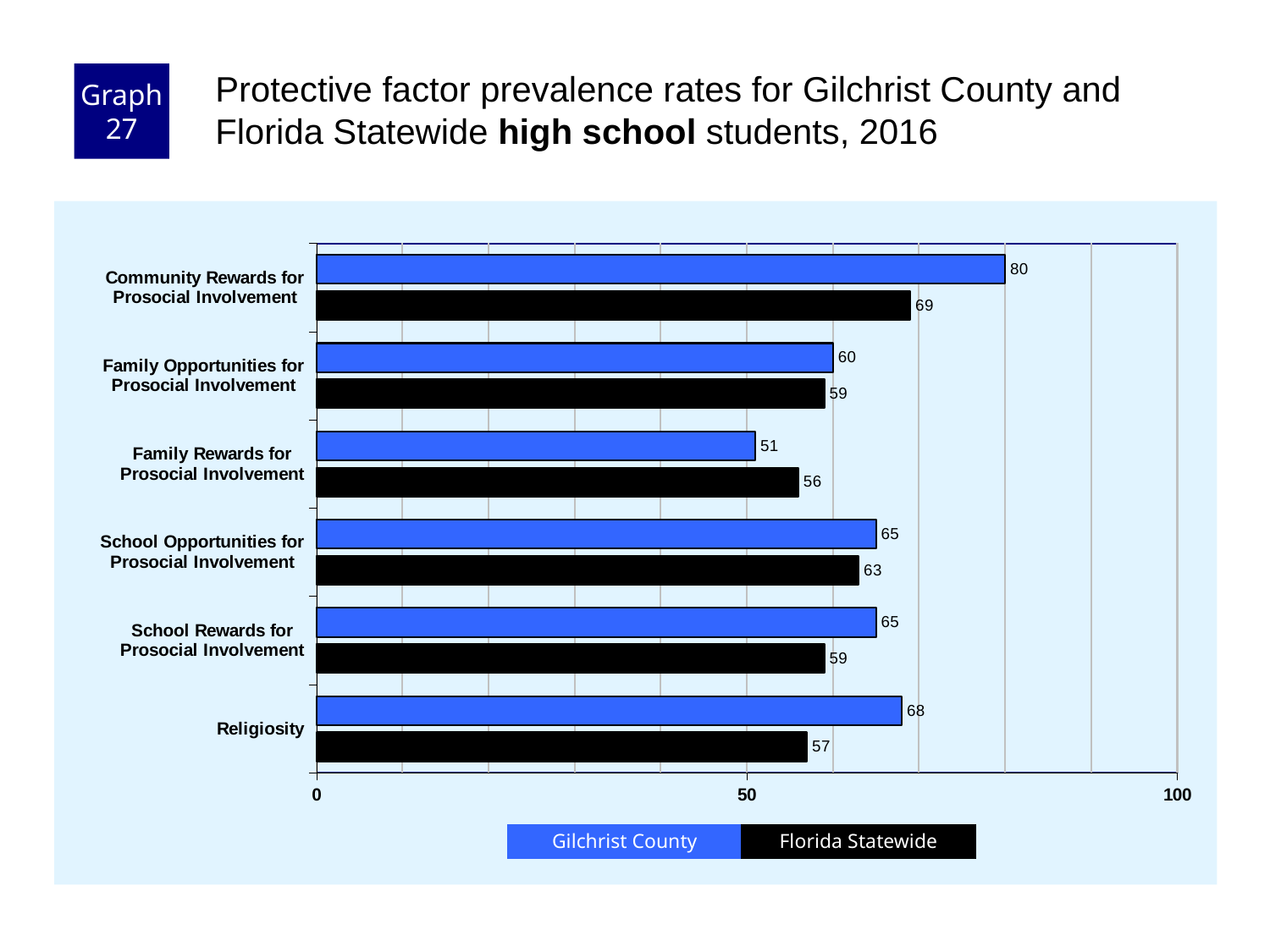
How many series does the legend list? 2 Which category has the highest Gilchrist County value? Community Rewards for Prosocial Involvement What kind of chart is shown on the slide? Bar chart What is the difference between the Gilchrist County and Florida Statewide values for Community Rewards for Prosocial Involvement? 11 What is the Florida Statewide value for Religiosity? 57 Which colour represents Florida Statewide in the chart? Black What is the Florida Statewide value for Family Rewards for Prosocial Involvement? 56 What is the Gilchrist County value for Community Rewards for Prosocial Involvement? 80 For Family Rewards for Prosocial Involvement, which is larger: the Gilchrist County value or the Florida Statewide value? Florida Statewide How many categories are shown on the chart? 6 Which category has the lowest Gilchrist County value? Family Rewards for Prosocial Involvement Is the Gilchrist County value for Religiosity greater or less than 50? greater